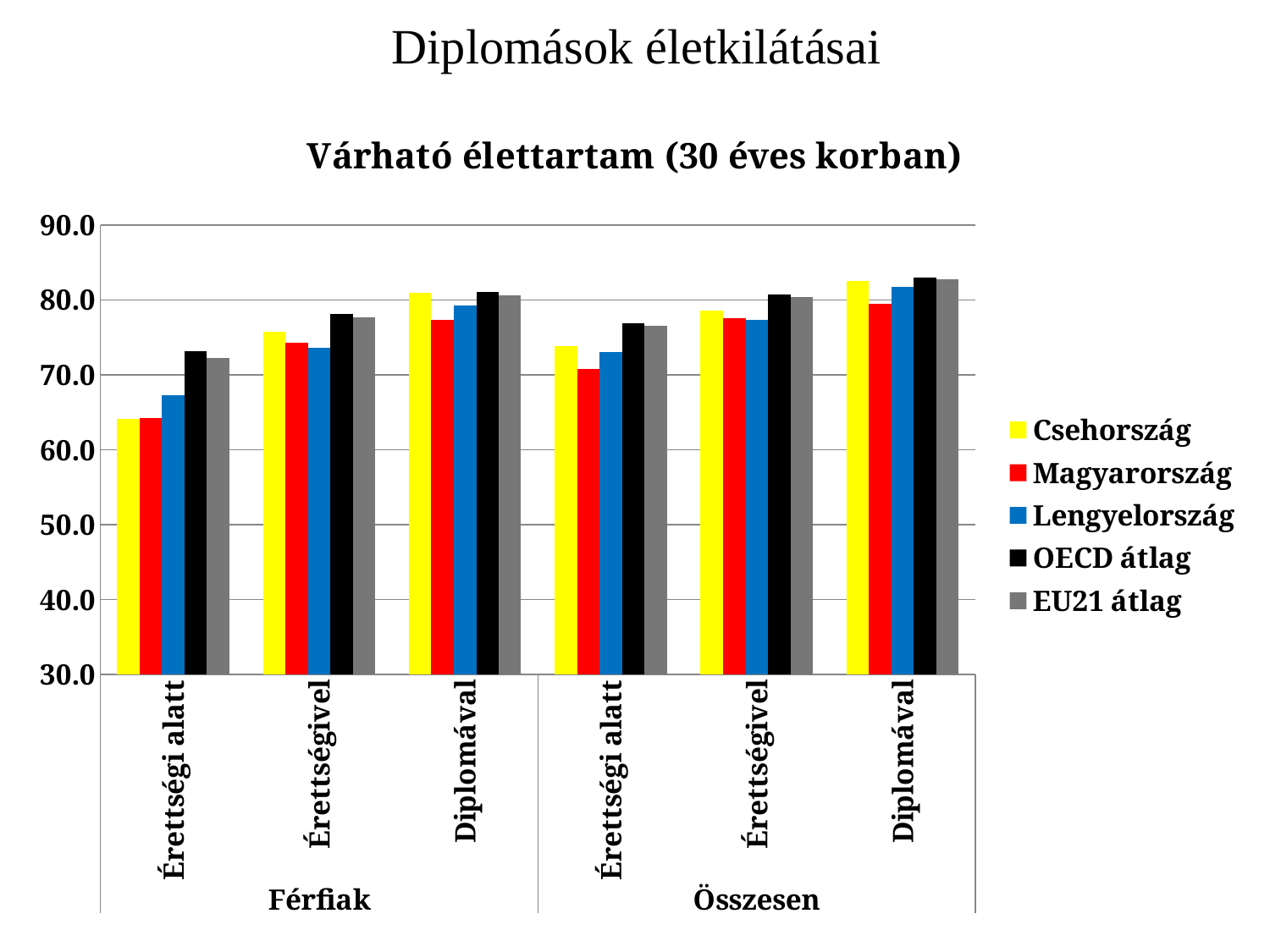
In the Összesen Érettségi alatt category, which series has the lowest value? Magyarország How many category groups of bars are plotted along the x axis? 6 Is the value for Csehország in the Összesen Diplomával category greater or less than 80.0? greater In the Férfiak Érettségi alatt category, which is larger: Lengyelország or Magyarország? Lengyelország Is the value for OECD átlag in the Férfiak Diplomával category greater or less than 80.0? greater What is the title of the chart? Várható élettartam (30 éves korban) Do the Csehország values rise or fall from Érettségi alatt to Diplomával within the Férfiak group? rise How many series does the legend list? 5 In the Férfiak Diplomával category, which series has the lowest value? Magyarország Is the value for Csehország in the Férfiak Érettségi alatt category greater or less than 70.0? less What kind of chart is shown on the slide? bar chart